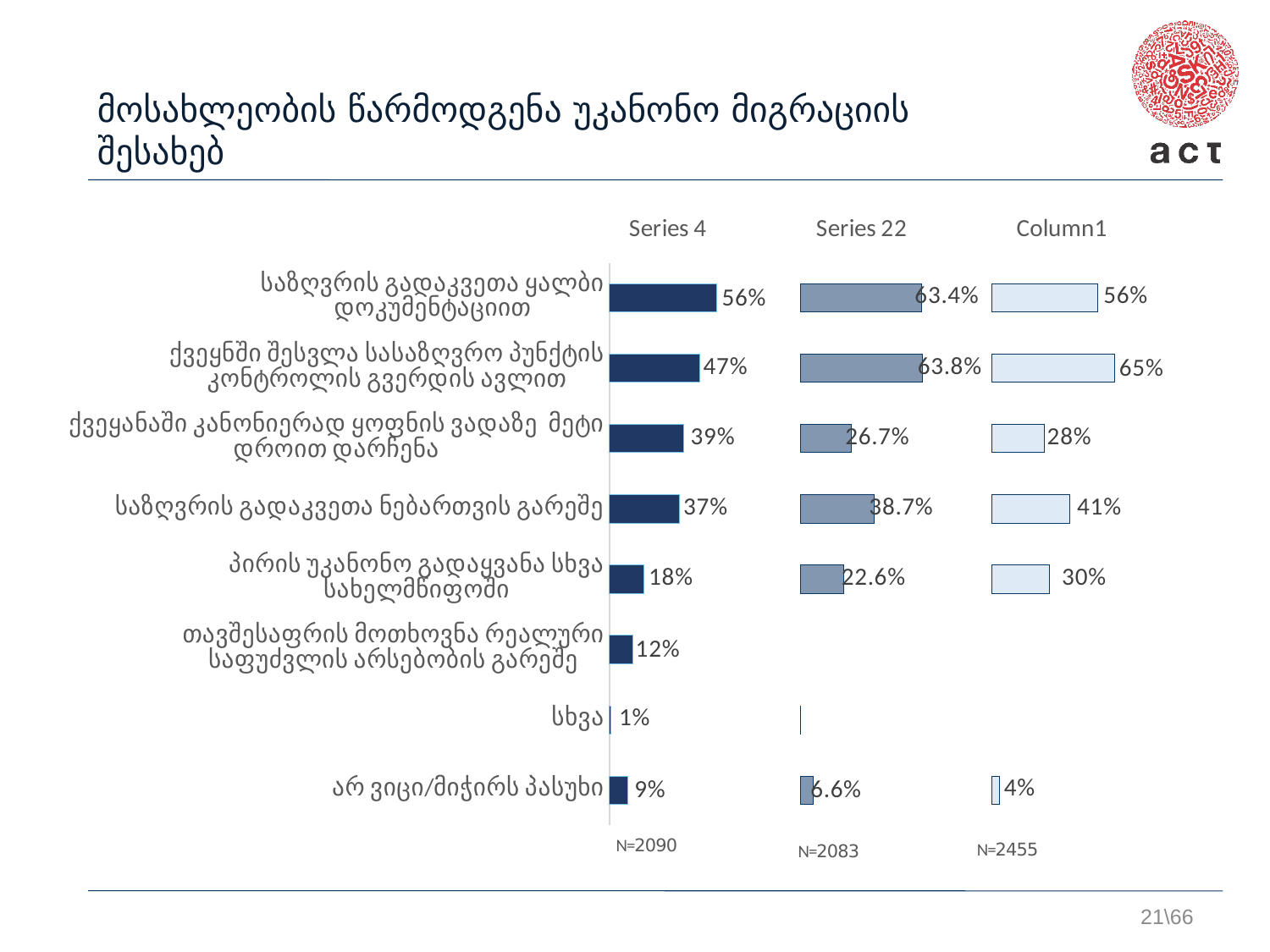
In the Series 4 chart, which category has the highest value? საზღვრის გადაკვეთა ყალბი დოკუმენტაციით In the Column1 chart, which category has the highest value? ქვეყნში შესვლა სასაზღვრო პუნქტის კონტროლის გვერდის ავლით In the Series 4 chart, which category has the lowest value? სხვა What is the N value shown under the Column1 chart? N=2455 In the Column1 chart, what is the value for არ ვიცი/მიჭირს პასუხი? 4% How many categories are listed in the Series 4 chart? 8 In the Series 4 chart, what is the difference between the values for საზღვრის გადაკვეთა ყალბი დოკუმენტაციით and ქვეყნში შესვლა სასაზღვრო პუნქტის კონტროლის გვერდის ავლით? 9% In the Series 4 chart, what is the value for საზღვრის გადაკვეთა ყალბი დოკუმენტაციით? 56% What kind of chart is the Series 4 chart? bar chart In the Series 22 chart, which is larger: the value for ქვეყანაში კანონიერად ყოფნის ვადაზე მეტი დროით დარჩენა or the value for საზღვრის გადაკვეთა ნებართვის გარეშე? საზღვრის გადაკვეთა ნებართვის გარეშე In the Series 22 chart, what is the value for ქვეყნში შესვლა სასაზღვრო პუნქტის კონტროლის გვერდის ავლით? 63.8% In the Column1 chart, what is the value for პირის უკანონო გადაყვანა სხვა სახელმწიფოში? 30%